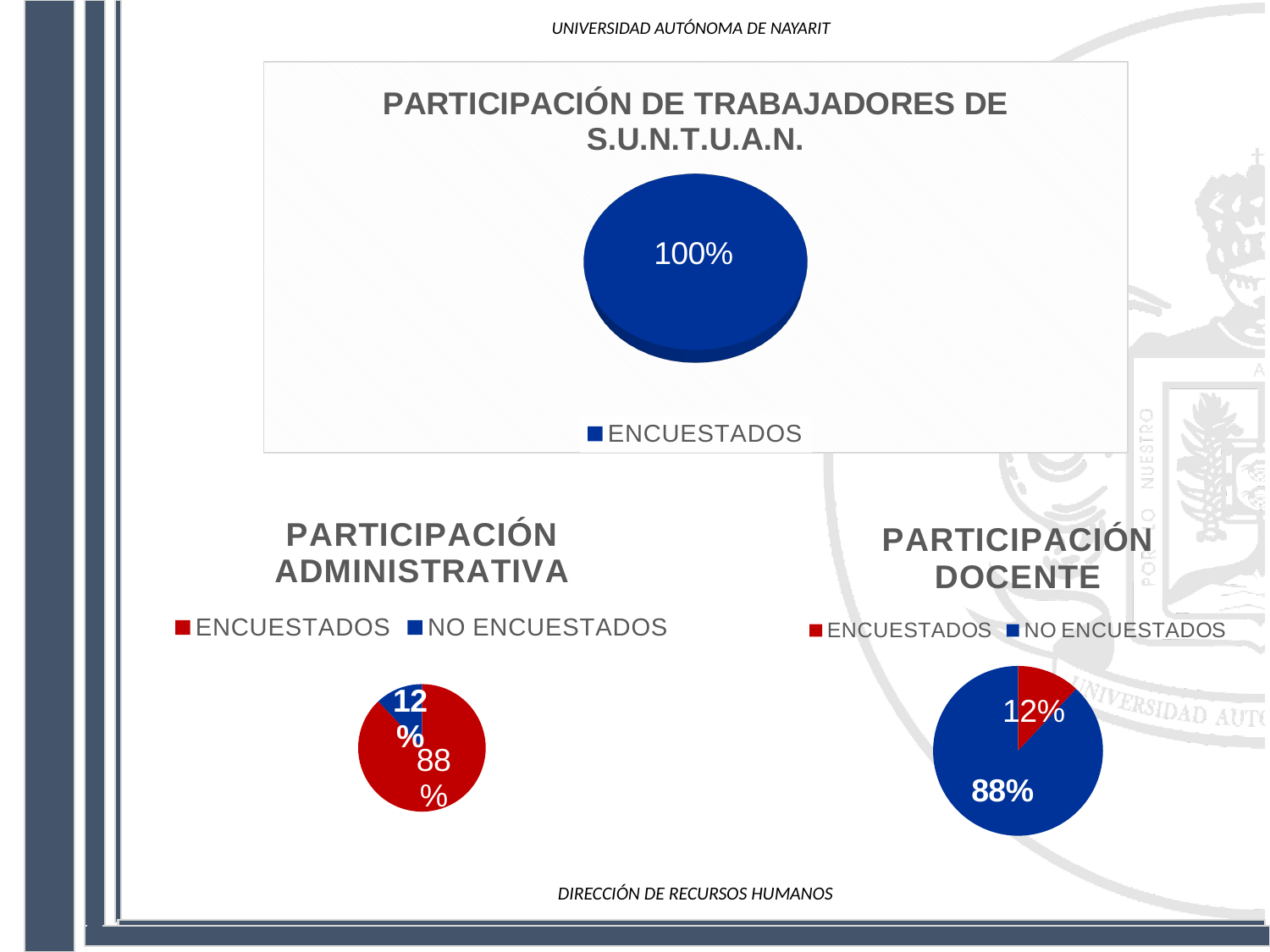
In the PARTICIPACIÓN DOCENTE chart, what share is NO ENCUESTADOS? 88% How many series does the legend of the PARTICIPACIÓN DE TRABAJADORES DE S.U.N.T.U.A.N. chart list? 1 How many slices does the PARTICIPACIÓN ADMINISTRATIVA pie chart have? 2 In the PARTICIPACIÓN ADMINISTRATIVA chart, which slice is larger, ENCUESTADOS or NO ENCUESTADOS? ENCUESTADOS In the PARTICIPACIÓN ADMINISTRATIVA chart, what share is ENCUESTADOS? 88% What kind of chart is the PARTICIPACIÓN DE TRABAJADORES DE S.U.N.T.U.A.N. chart? Pie chart In the PARTICIPACIÓN DOCENTE chart, what is the difference between the NO ENCUESTADOS and ENCUESTADOS shares? 76% In the PARTICIPACIÓN DOCENTE chart, which slice is the largest? NO ENCUESTADOS In the PARTICIPACIÓN DOCENTE chart, what colour represents NO ENCUESTADOS? Blue In the PARTICIPACIÓN DOCENTE chart, what share is ENCUESTADOS? 12% In the PARTICIPACIÓN DE TRABAJADORES DE S.U.N.T.U.A.N. chart, what percentage is shown for ENCUESTADOS? 100%